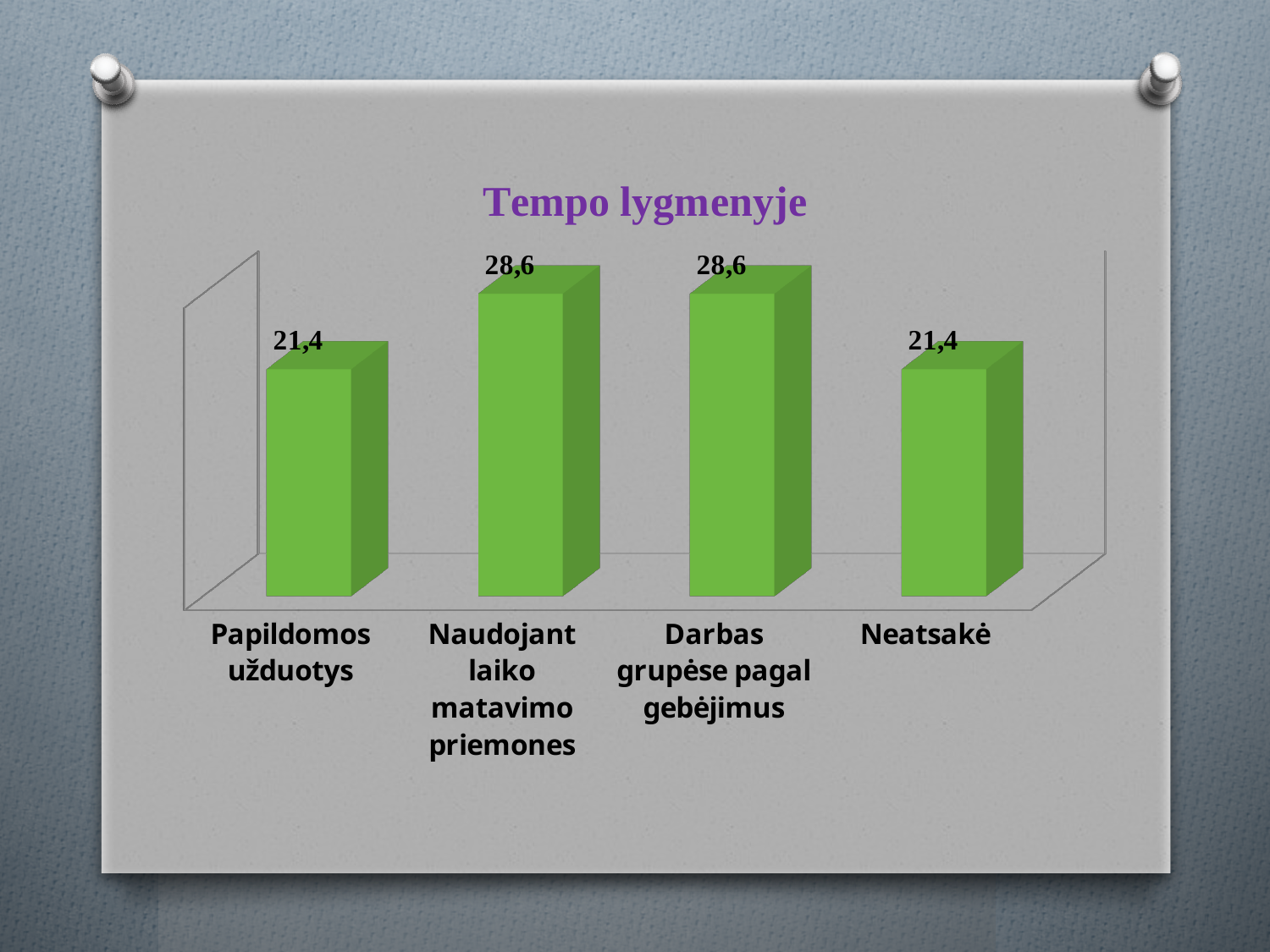
What kind of chart is shown on the slide? Bar chart How many categories are shown in the chart? 4 What is the value for Papildomos užduotys? 21,4 What is the title of the chart? Tempo lygmenyje Which is larger, the value for Papildomos užduotys or the value for Naudojant laiko matavimo priemones? Naudojant laiko matavimo priemones What is the value for Darbas grupėse pagal gebėjimus? 28,6 What is the difference between the value for Naudojant laiko matavimo priemones and the value for Papildomos užduotys? 7,2 What colour are the bars in the chart? Green What is the difference between the value for Darbas grupėse pagal gebėjimus and the value for Neatsakė? 7,2 What is the value for Naudojant laiko matavimo priemones? 28,6 What is the value for Neatsakė? 21,4 Which is larger, the value for Darbas grupėse pagal gebėjimus or the value for Neatsakė? Darbas grupėse pagal gebėjimus